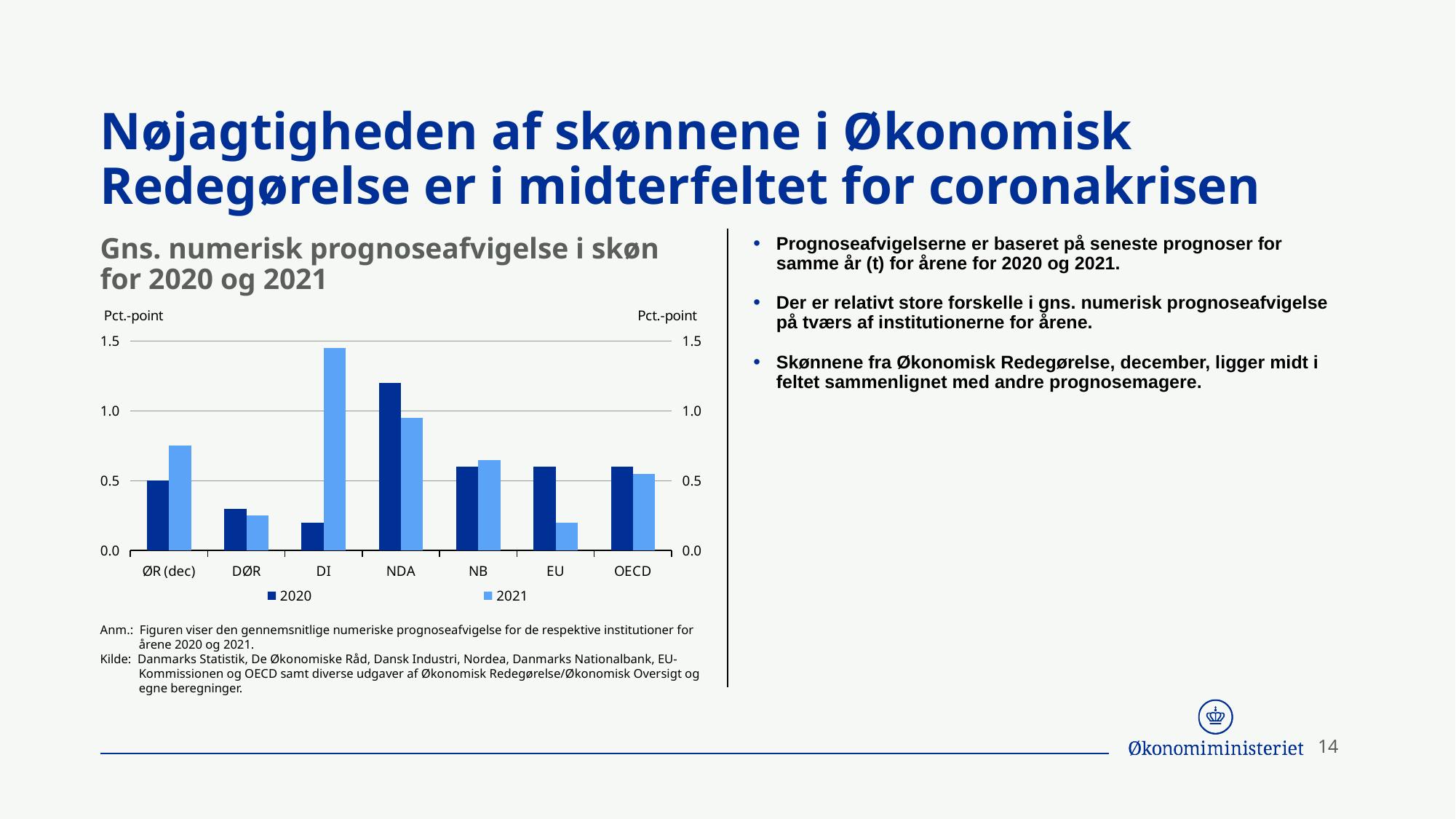
Is the 2021 value for EU greater or less than 0.5? less Which institution has the highest 2020 value in the chart? NDA For DI, which is larger: the 2020 value or the 2021 value? 2021 Which institution has the highest 2021 value in the chart? DI How many series does the chart's legend list? 2 Which institution has the lowest 2020 value in the chart? DI What unit is shown on the chart's vertical axis? Pct.-point What kind of chart is shown on the slide? bar chart For NDA, which is larger: the 2020 value or the 2021 value? 2020 Is the 2021 value for DI greater or less than 1.0? greater How many institutions (categories) are shown on the x axis of the chart? 7 Which institution has the lowest 2021 value in the chart? EU